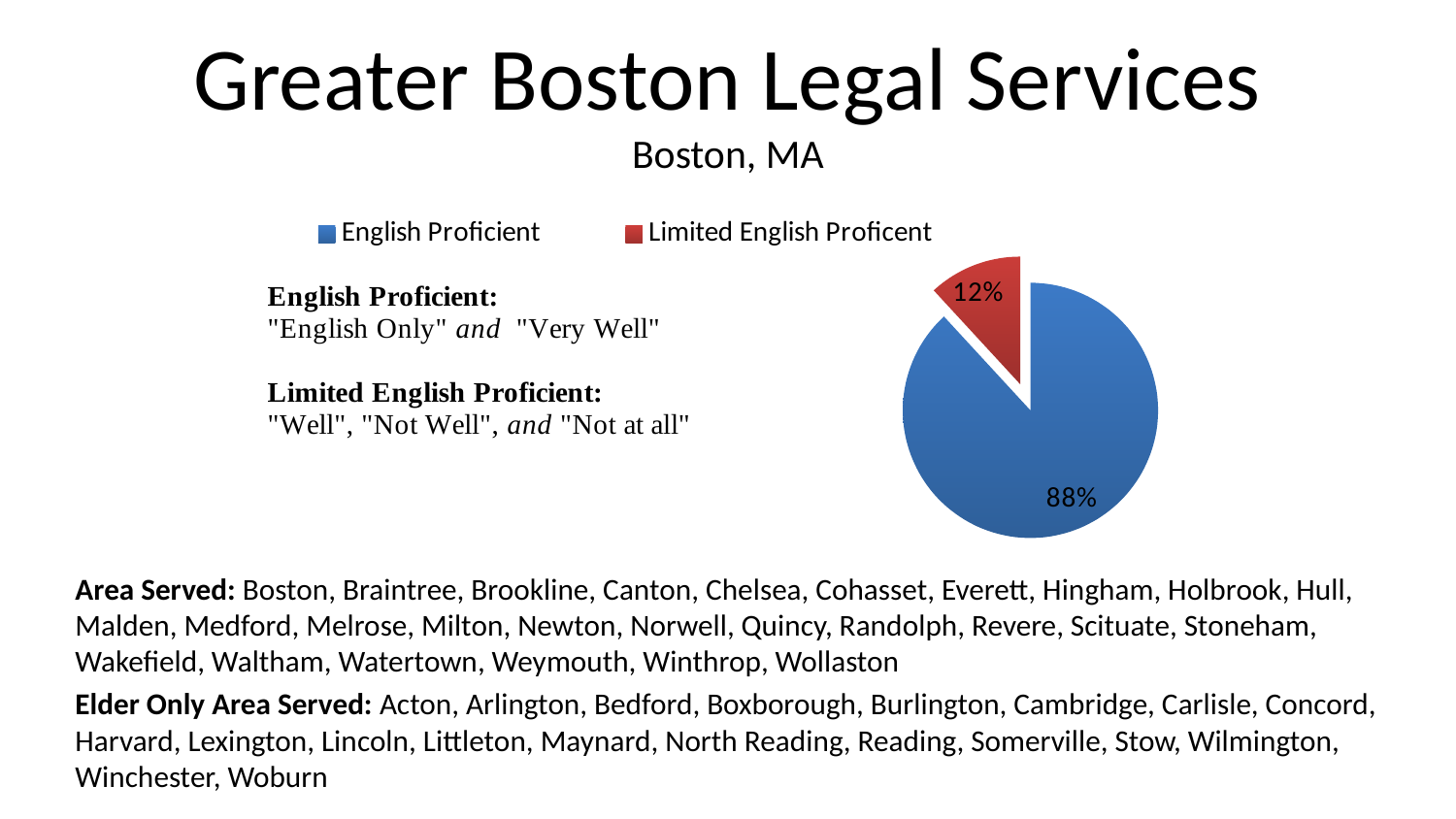
How many slices does the pie chart have? 2 What kind of chart is shown on the slide? pie chart What colour is the English Proficient slice? blue What percentage of the pie is English Proficient? 88% What percentage of the pie is Limited English Proficent? 12% Which slice of the pie is the smallest? Limited English Proficent How many entries does the legend list? 2 Which is larger, the English Proficient slice or the Limited English Proficent slice? English Proficient Which slice of the pie is the largest? English Proficient What is the difference in percentage points between the English Proficient and Limited English Proficent slices? 76 What colour is the Limited English Proficent slice? red